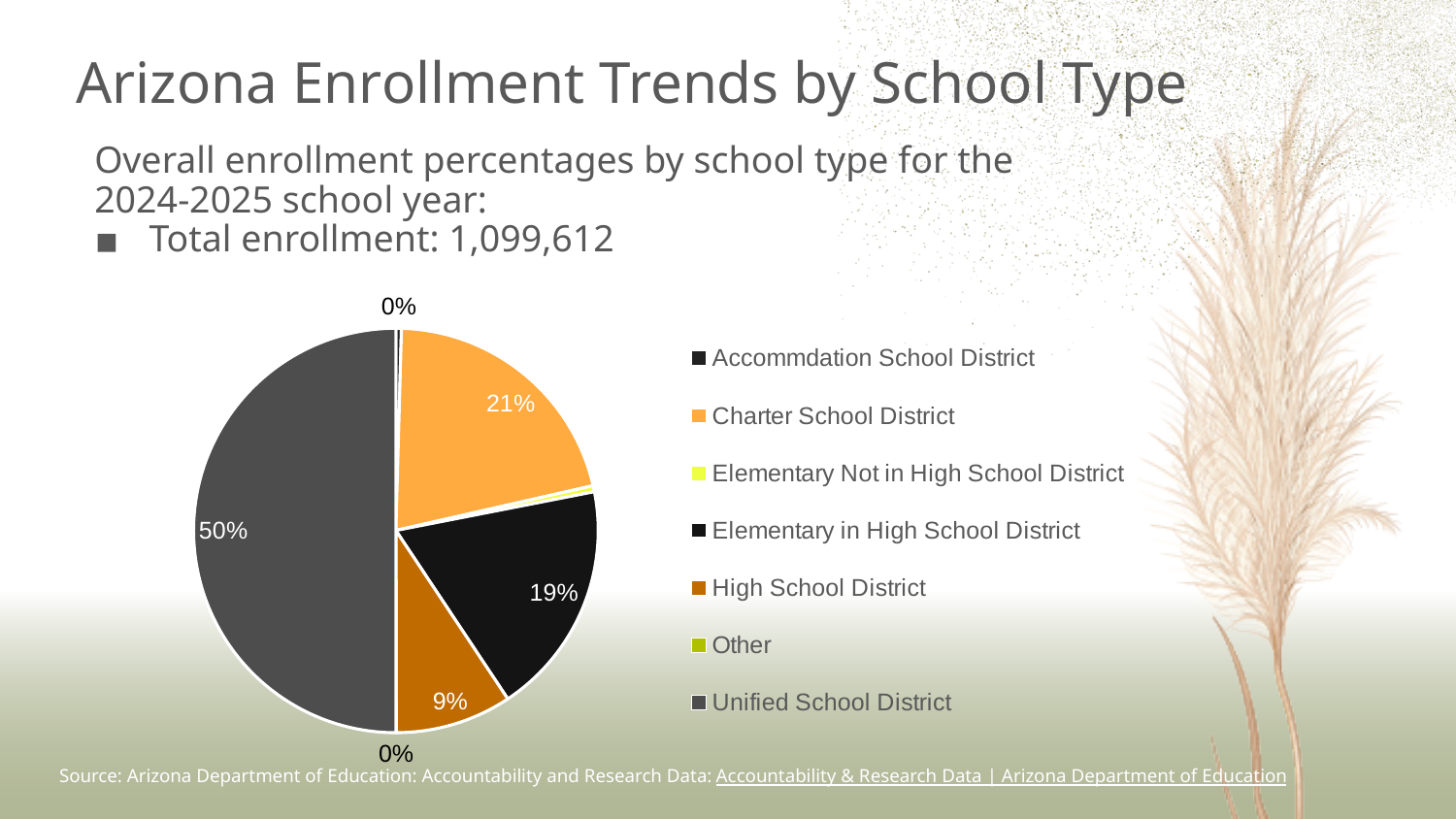
What percentage is shown for the Accommodation School District slice? 0% What percentage of enrollment is in the High School District category? 9% Which school type has the largest share of enrollment? Unified School District What is the difference in percentage points between Unified School District and Charter School District? 29 percentage points Which has a larger share: Charter School District or Elementary in High School District? Charter School District What kind of chart is shown on the slide? Pie chart How many categories does the legend list? 7 What is the difference in percentage points between Charter School District and High School District? 12 percentage points What percentage of enrollment is in the Elementary in High School District category? 19% What percentage of enrollment is in the Charter School District category? 21% What is the title of the slide containing the chart? Arizona Enrollment Trends by School Type What percentage of enrollment is in the Unified School District category? 50%